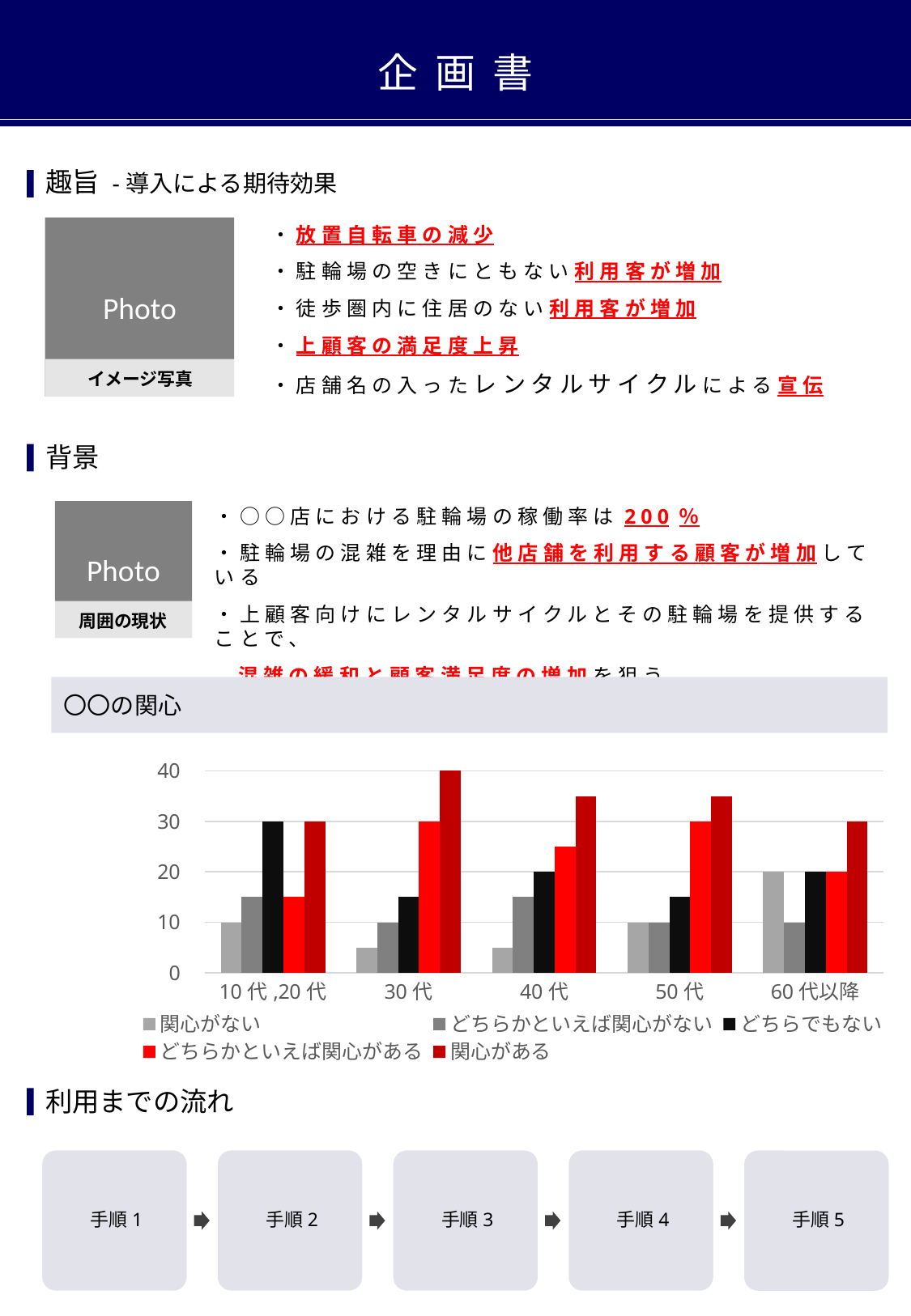
In the 〇〇の関心 chart, is the value of 関心がない for 30代 greater or less than 10? less In the 〇〇の関心 chart, which is larger: 関心がある for 30代 or 関心がある for 60代以降? 30代 In the 〇〇の関心 chart, what is the value of どちらでもない for 10代,20代? 30 In the 〇〇の関心 chart, what is the value of 関心がない for 60代以降? 20 In the 〇〇の関心 chart, what is the difference between 関心がある for 30代 and 関心がある for 10代,20代? 10 In the 〇〇の関心 chart, what is the value of 関心がある for 30代? 40 In the 〇〇の関心 chart, is the value of 関心がある for 40代 greater or less than 30? greater In the 〇〇の関心 chart, what is the value of どちらかといえば関心がある for 50代? 30 How many series does the legend of the 〇〇の関心 chart list? 5 In the 〇〇の関心 chart, which age group has the highest value for 関心がある? 30代 How many age-group categories are shown on the x axis of the 〇〇の関心 chart? 5 What kind of chart is shown under the heading 〇〇の関心? bar chart